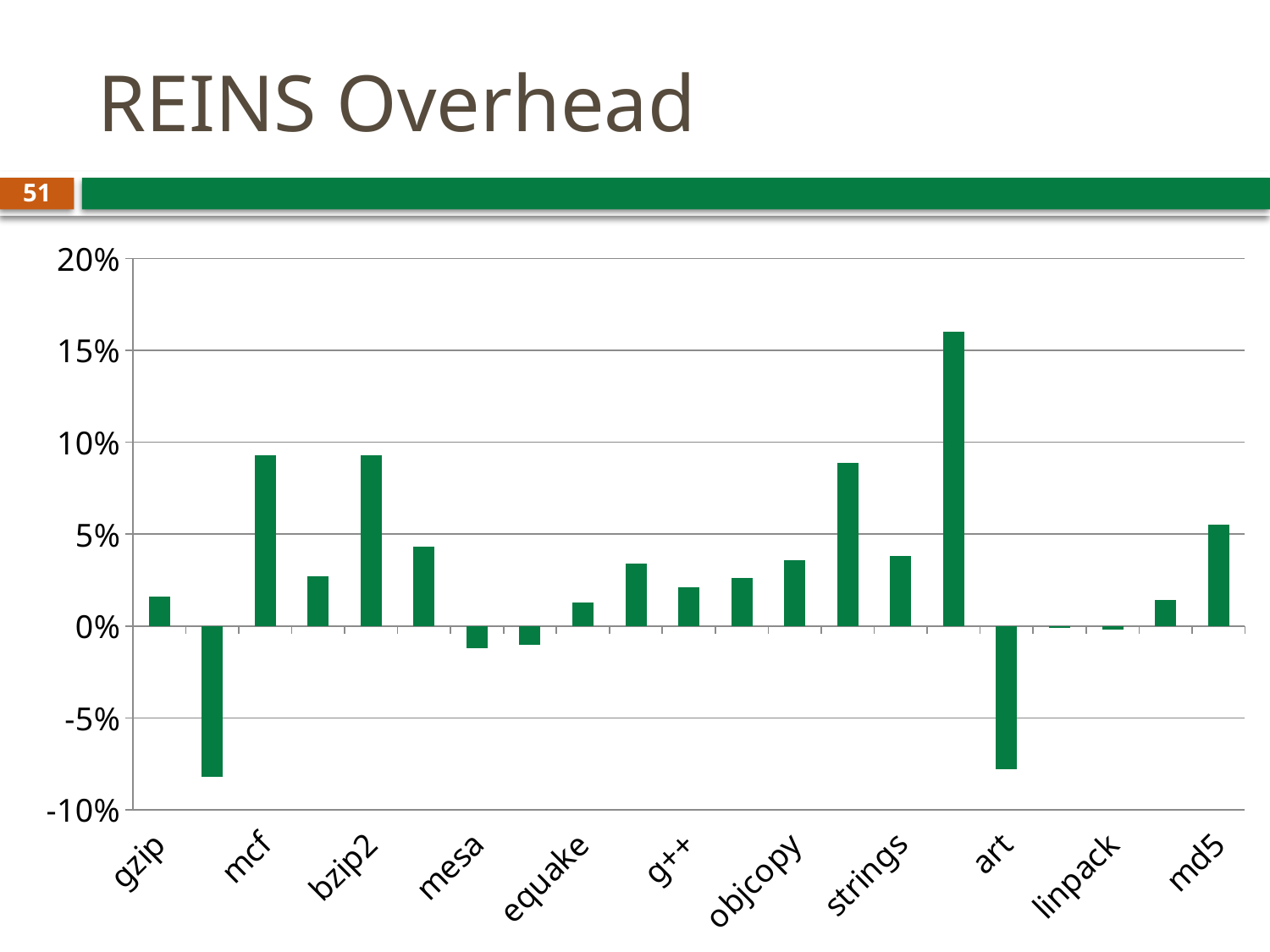
Is the value for mesa greater or less than 0%? less What kind of chart is shown on the slide? bar chart Is the value for md5 greater or less than 10%? less What is the title of the chart? REINS Overhead What colour are the bars in the chart? green Is the value for bzip2 greater or less than 5%? greater Which has the larger value, art or md5? md5 Which has the larger value, mcf or gzip? mcf How many category labels are shown along the x axis? 11